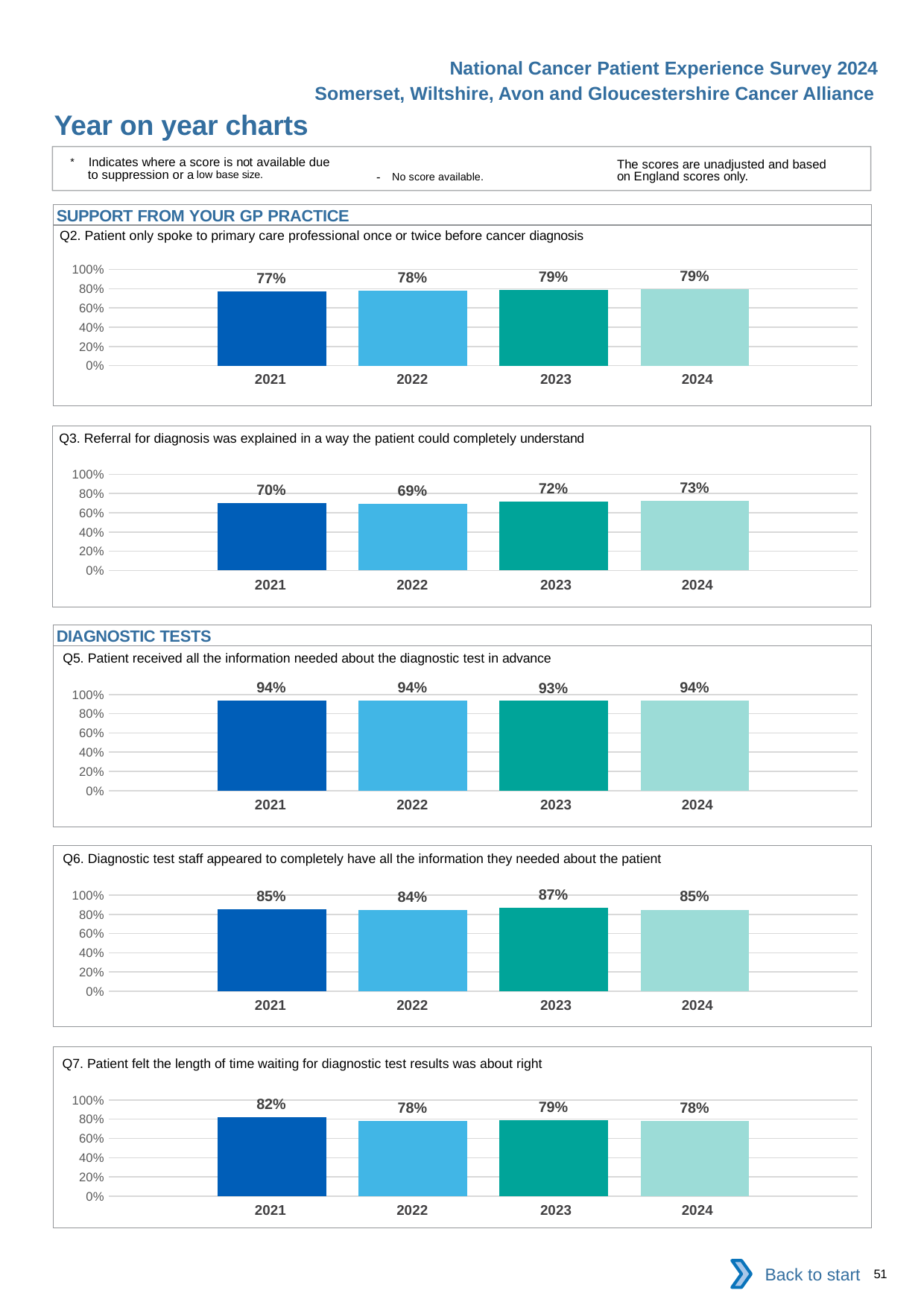
In the Q2 chart (patient only spoke to primary care professional once or twice before cancer diagnosis), do the values rise or fall from 2021 to 2023? rise In the Q7 chart (patient felt the length of time waiting for diagnostic test results was about right), what is the value for 2024? 78% In the Q3 chart (referral for diagnosis was explained in a way the patient could completely understand), which year has the lowest value? 2022 In the Q3 chart (referral for diagnosis was explained in a way the patient could completely understand), what is the difference between the 2024 and 2021 values? 3% In the Q7 chart (patient felt the length of time waiting for diagnostic test results was about right), is the value for 2021 larger than the value for 2022? yes What type of chart is the Q7 chart (patient felt the length of time waiting for diagnostic test results was about right)? bar chart In the Q6 chart (diagnostic test staff appeared to completely have all the information they needed about the patient), which year has the highest value? 2023 In the Q6 chart (diagnostic test staff appeared to completely have all the information they needed about the patient), what is the difference between the 2023 and 2022 values? 3% How many years are shown in the Q5 chart (patient received all the information needed about the diagnostic test in advance)? 4 In the Q2 chart (patient only spoke to primary care professional once or twice before cancer diagnosis), what is the value for 2021? 77% In the Q7 chart (patient felt the length of time waiting for diagnostic test results was about right), which year has the highest value? 2021 In the Q5 chart (patient received all the information needed about the diagnostic test in advance), what is the value for 2023? 93%